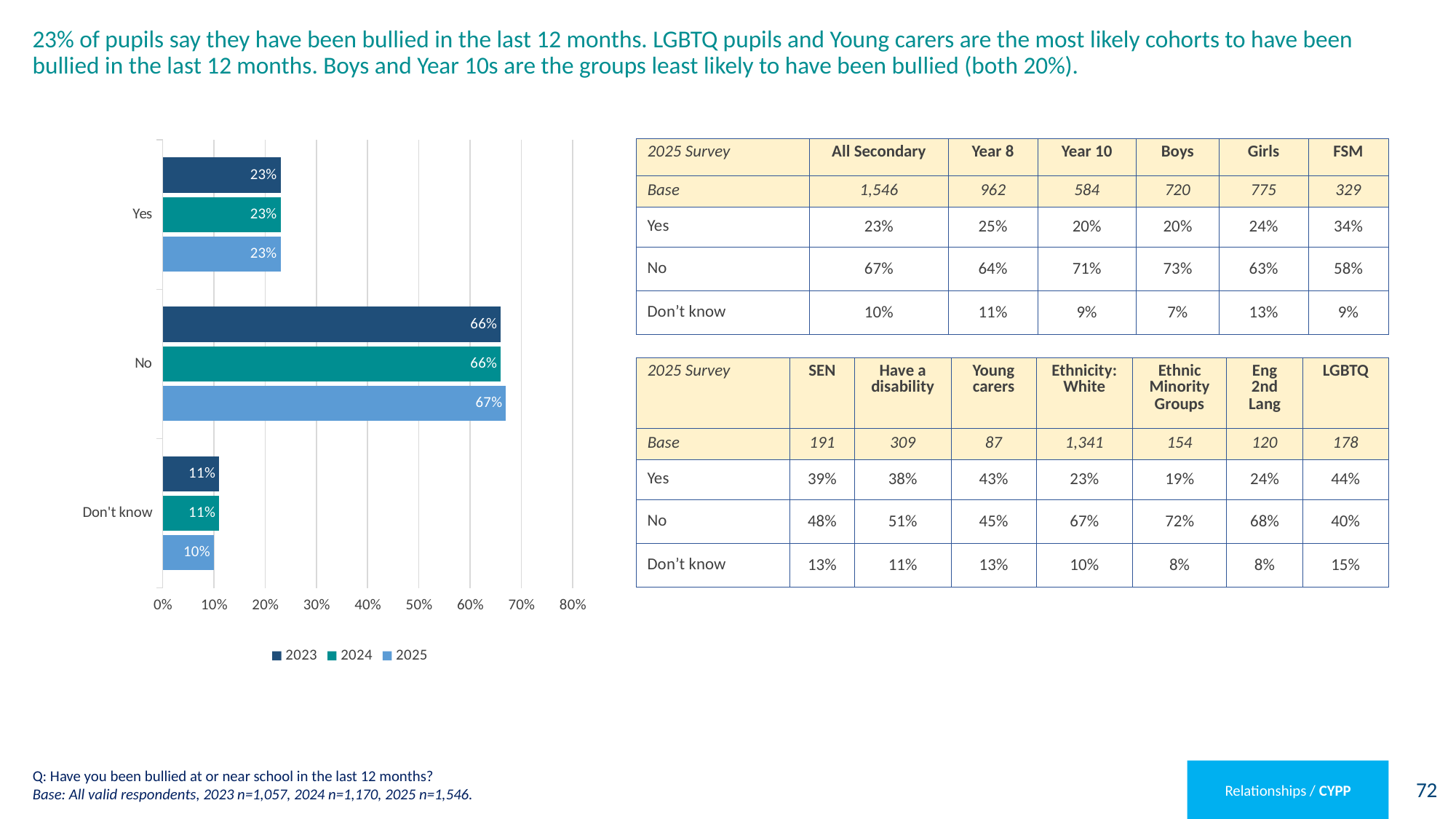
How many series does the chart legend list? 3 What is the difference between the 'No' and 'Yes' values in the 2025 series? 44% What kind of chart is shown on the slide? bar chart What is the value for 'No' in the 2025 series? 67% Which category has the highest value in the 2024 series? No How many categories are shown on the chart's y axis? 3 What is the value for 'Yes' in the 2025 series? 23% What is the value for 'Don't know' in the 2023 series? 11% What is the value for 'No' in the 2023 series? 66% Which category has the lowest value in the 2025 series? Don't know Which is larger in the 2025 series: the value for 'Yes' or the value for 'Don't know'? Yes Which series does the darkest blue bar represent according to the legend? 2023